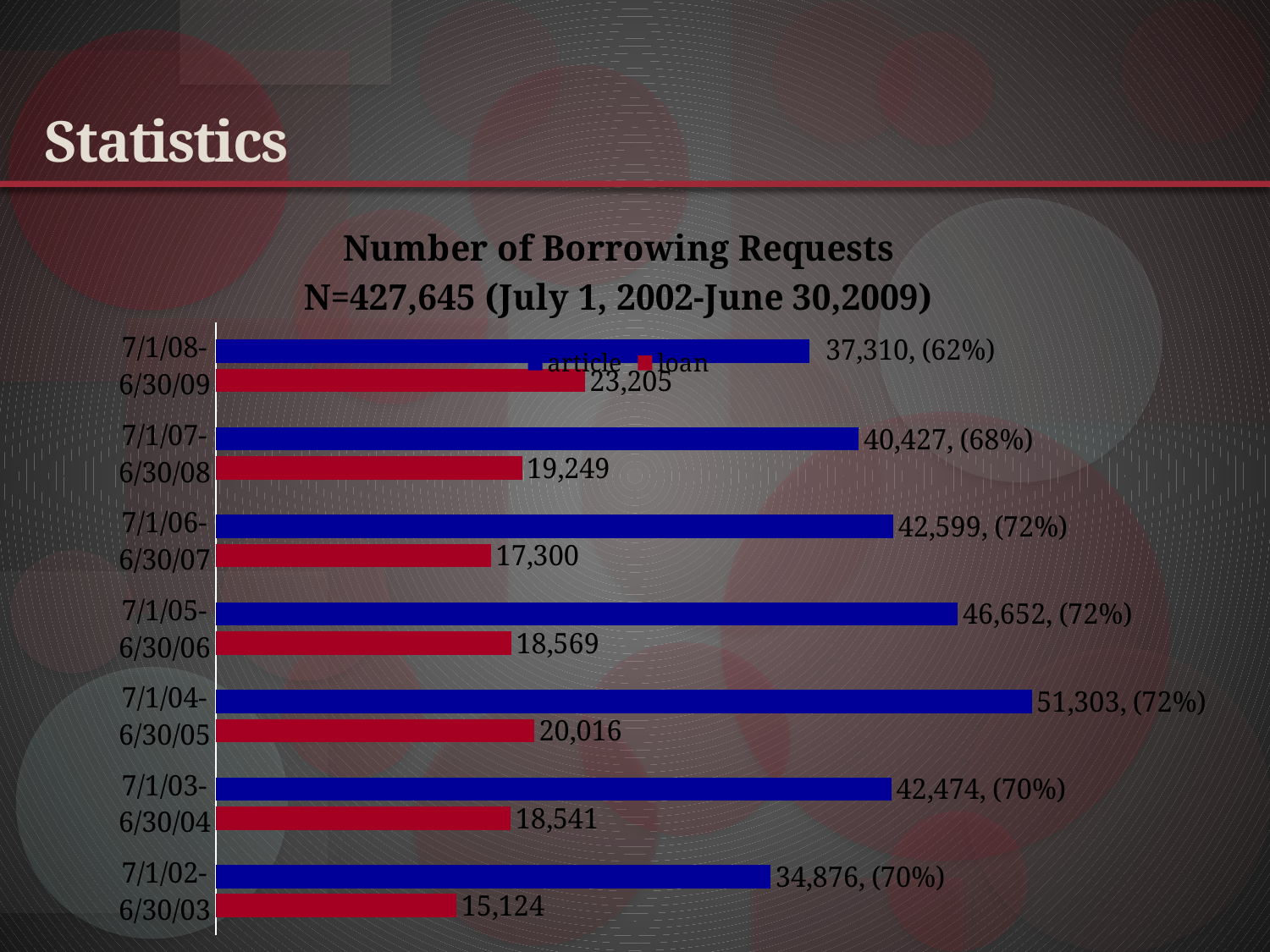
What is the title of the chart? Number of Borrowing Requests N=427,645 (July 1, 2002-June 30,2009) How many series does the legend list? 2 What is the combined total of article and loan requests for 7/1/02-6/30/03? 50,000 What is the number of loan requests for 7/1/06-6/30/07? 17,300 Which period has the highest number of article requests? 7/1/04-6/30/05 What is the difference between article and loan requests for 7/1/04-6/30/05? 31,287 What is the number of article requests for 7/1/04-6/30/05? 51,303 Which period has the lowest number of loan requests? 7/1/02-6/30/03 Which is larger, the loan value for 7/1/07-6/30/08 or the loan value for 7/1/06-6/30/07? 7/1/07-6/30/08 How many time periods (categories) are shown on the chart? 7 What percentage is shown next to the article value for 7/1/08-6/30/09? 62% What type of chart is shown on the slide? bar chart